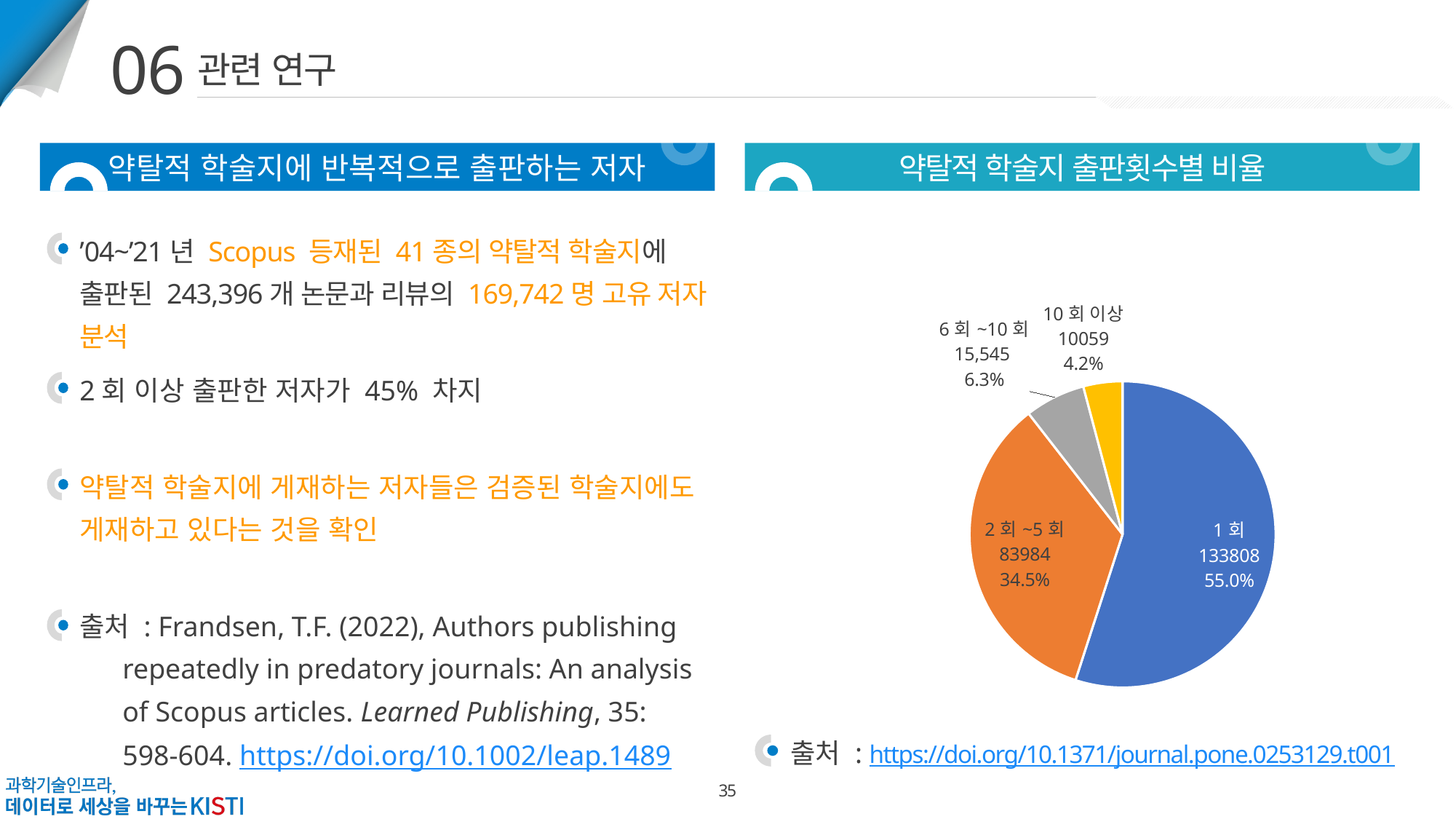
What kind of chart is shown on the slide? pie chart Which category has the largest slice? 1 회 What share of the pie does the 1 회 slice represent? 55.0% How many slices does the pie chart have? 4 What is the difference between the values for 1 회 and 2 회 ~5 회? 49824 Which category has the smallest slice? 10 회 이상 What is the value for the 6 회 ~10 회 slice? 15,545 Which is larger, the value for 6 회 ~10 회 or the value for 10 회 이상? 6 회 ~10 회 What is the value for the 1 회 slice? 133808 What share of the pie does the 2 회 ~5 회 slice represent? 34.5% What is the value for the 2 회 ~5 회 slice? 83984 What is the value for the 10 회 이상 slice? 10059